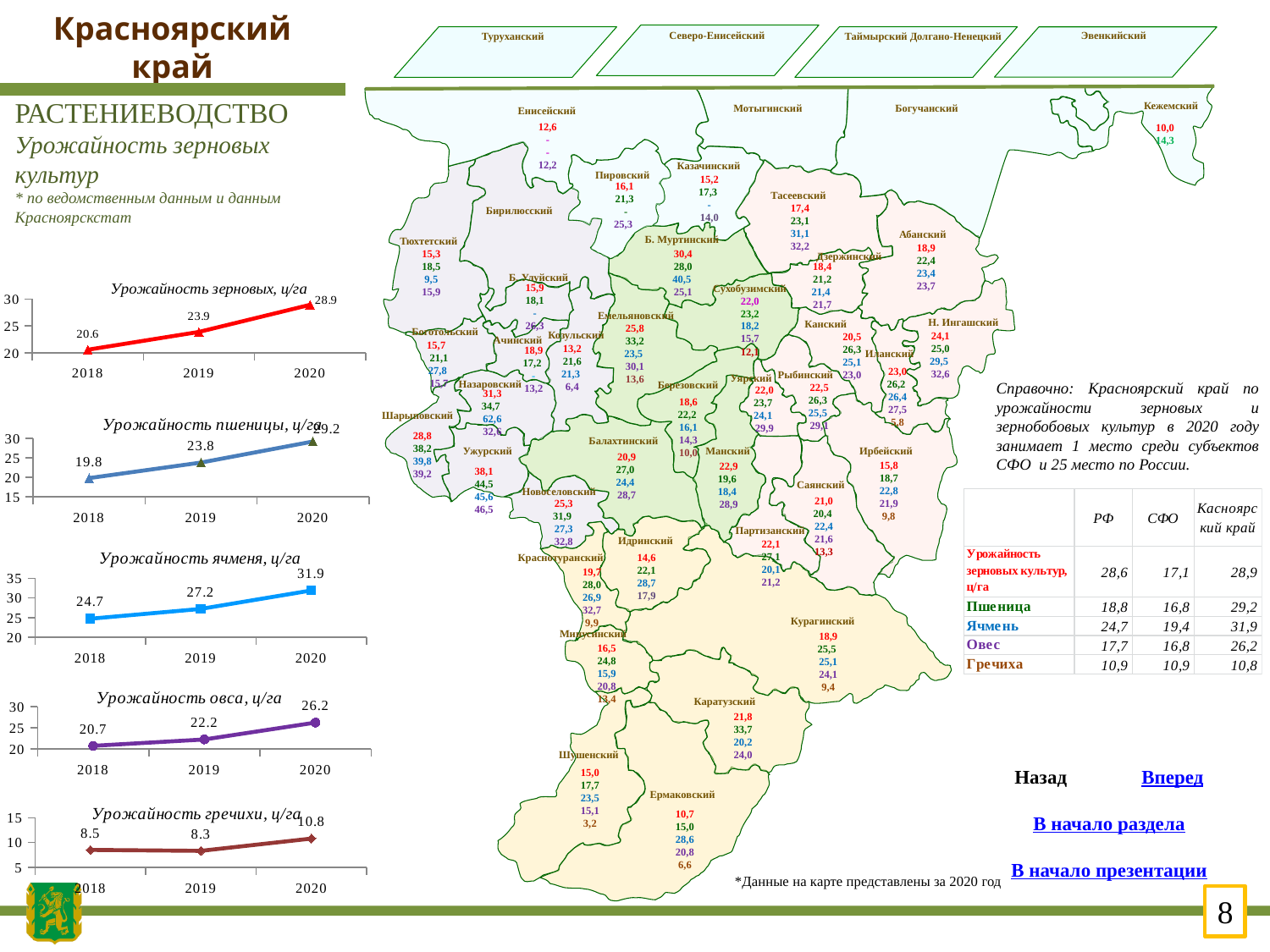
On the chart 'Урожайность зерновых, ц/га', what is the value for 2020? 28.9 On the chart 'Урожайность овса, ц/га', what is the value for 2020? 26.2 On the chart 'Урожайность гречихи, ц/га', is the value for 2020 greater or less than 10? greater On the chart 'Урожайность овса, ц/га', what is the difference between the 2019 and 2018 values? 1.5 On the chart 'Урожайность гречихи, ц/га', which year has the lowest value? 2019 On the chart 'Урожайность пшеницы, ц/га', what is the value for 2018? 19.8 On the chart 'Урожайность пшеницы, ц/га', which is larger, the value for 2019 or the value for 2020? 2020 On the chart 'Урожайность ячменя, ц/га', what is the value for 2019? 27.2 On the chart 'Урожайность ячменя, ц/га', which year has the highest value? 2020 How many data points are plotted on the chart 'Урожайность ячменя, ц/га'? 3 What kind of chart is 'Урожайность овса, ц/га'? line chart On the chart 'Урожайность зерновых, ц/га', what is the difference between the 2020 and 2018 values? 8.3